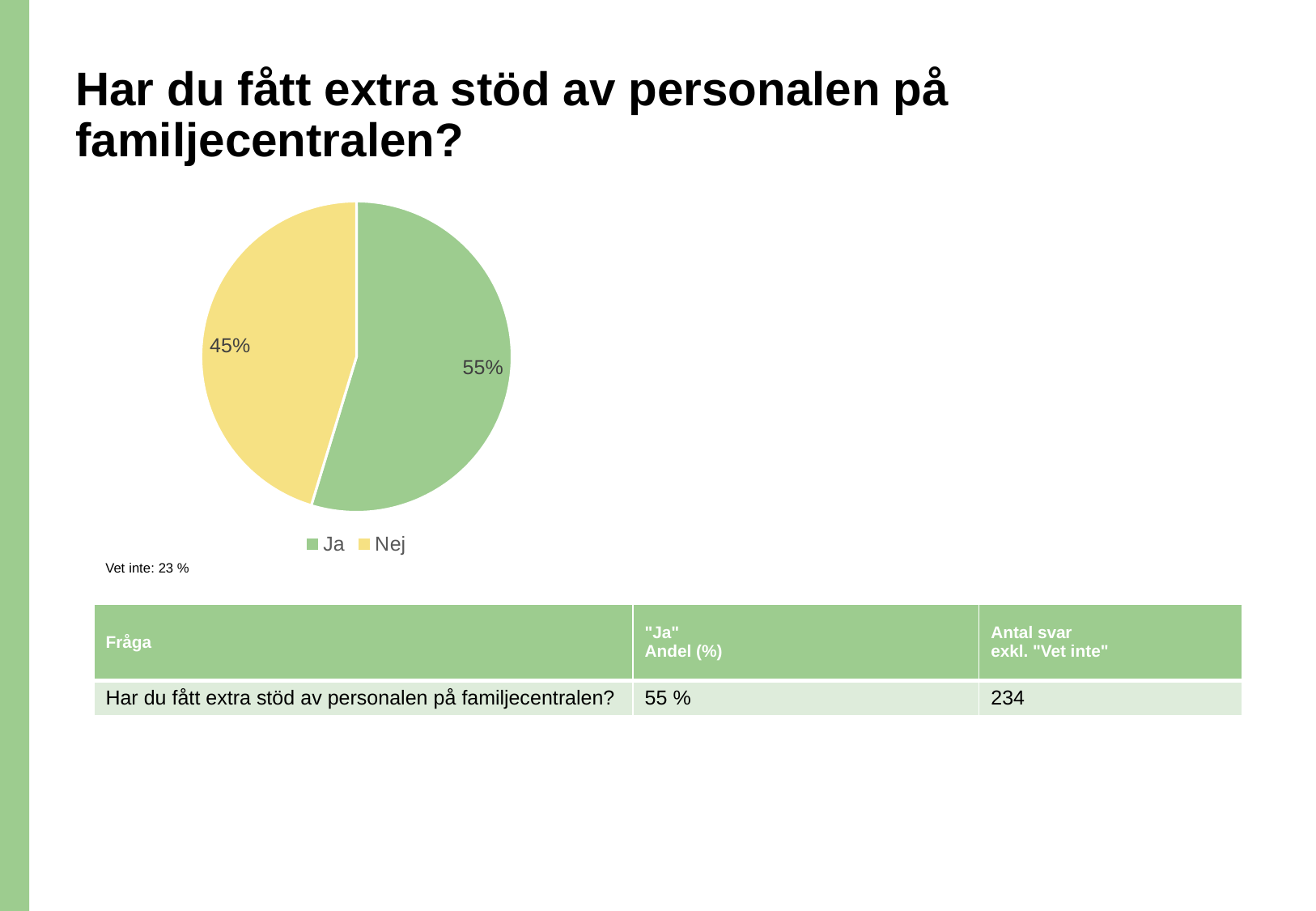
What colour is the "Ja" slice in the pie chart? green What colour is the "Nej" slice in the pie chart? yellow What share of the pie does "Nej" represent? 45% Which slice of the pie is the largest? Ja What is the difference in percentage points between the "Ja" and "Nej" slices? 10 How many slices does the pie chart have? 2 Which is larger, the "Ja" slice or the "Nej" slice? Ja What is the total of the two slices shown in the pie chart? 100% What share of the pie does "Ja" represent? 55% Which slice of the pie is the smallest? Nej What kind of chart is shown on the slide? pie chart How many entries does the legend list? 2